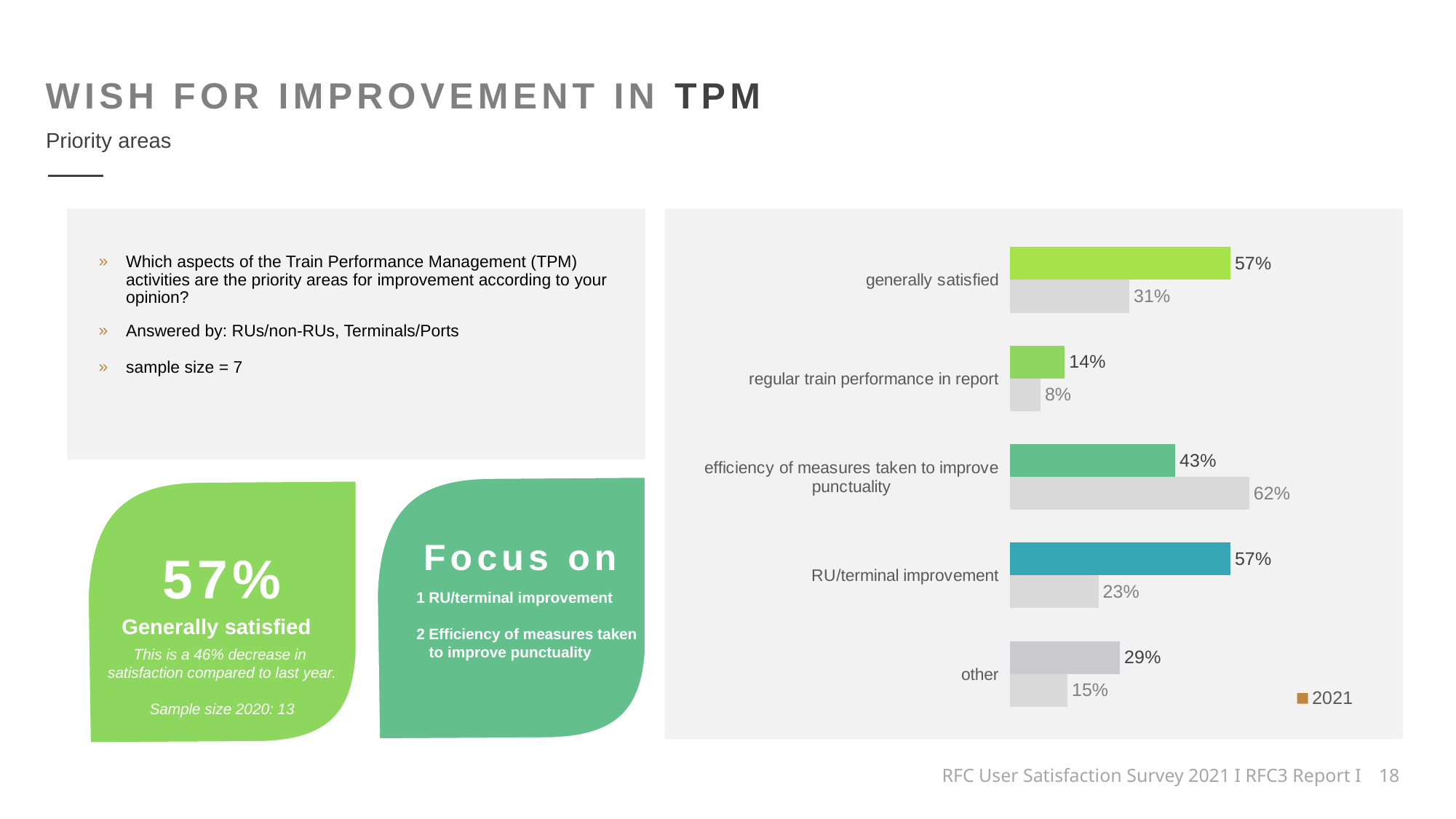
What kind of chart is shown on the right of the slide? bar chart What is the difference between the upper and lower bars for 'RU/terminal improvement'? 34 percentage points Which category has the highest value among the lower (grey) bars? efficiency of measures taken to improve punctuality What is the value of the lower (grey) bar for 'generally satisfied'? 31% What is the value of the lower (grey) bar for 'efficiency of measures taken to improve punctuality'? 62% What is the value of the upper (coloured) bar for 'generally satisfied'? 57% For 'efficiency of measures taken to improve punctuality', which bar is larger, the upper coloured bar or the lower grey bar? the lower grey bar How many categories are shown on the chart? 5 Which category has the lowest value among the upper (coloured) bars? regular train performance in report How many series does the chart's legend list? 1 What is the value of the upper (coloured) bar for 'regular train performance in report'? 14% What is the value of the upper bar for 'RU/terminal improvement'? 57%